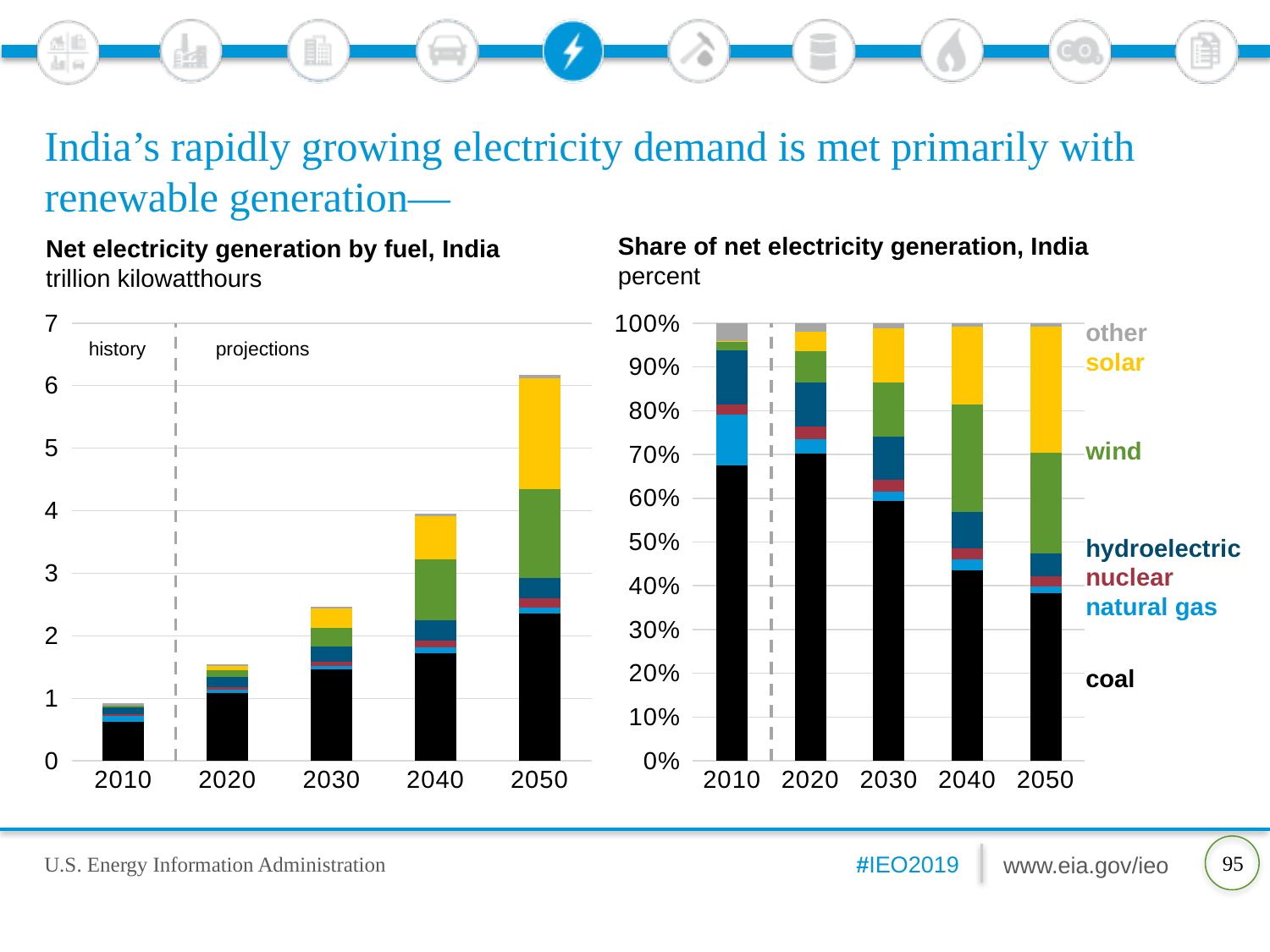
In the right chart, 'Share of net electricity generation, India', is the solar share larger in 2050 or in 2020? 2050 In the right chart, 'Share of net electricity generation, India', does the coal share rise or fall from 2010 to 2050? fall In the right chart, 'Share of net electricity generation, India', how many fuel categories are labelled? 7 In the left chart, 'Net electricity generation by fuel, India', which year has the highest total net electricity generation? 2050 In the left chart, 'Net electricity generation by fuel, India', which year has the lowest total net electricity generation? 2010 In the left chart, 'Net electricity generation by fuel, India', is the total generation in 2030 greater or less than 2 trillion kilowatthours? greater In the left chart, 'Net electricity generation by fuel, India', does total net electricity generation rise or fall from 2010 to 2050? rise In the left chart, 'Net electricity generation by fuel, India', is the total generation in 2010 greater or less than 1 trillion kilowatthours? less What unit is used on the left chart, 'Net electricity generation by fuel, India'? trillion kilowatthours In the left chart, 'Net electricity generation by fuel, India', how many years are shown on the x axis? 5 In the right chart, 'Share of net electricity generation, India', is the coal share in 2010 greater or less than 60%? greater What kind of chart is the left chart, 'Net electricity generation by fuel, India'? stacked bar chart